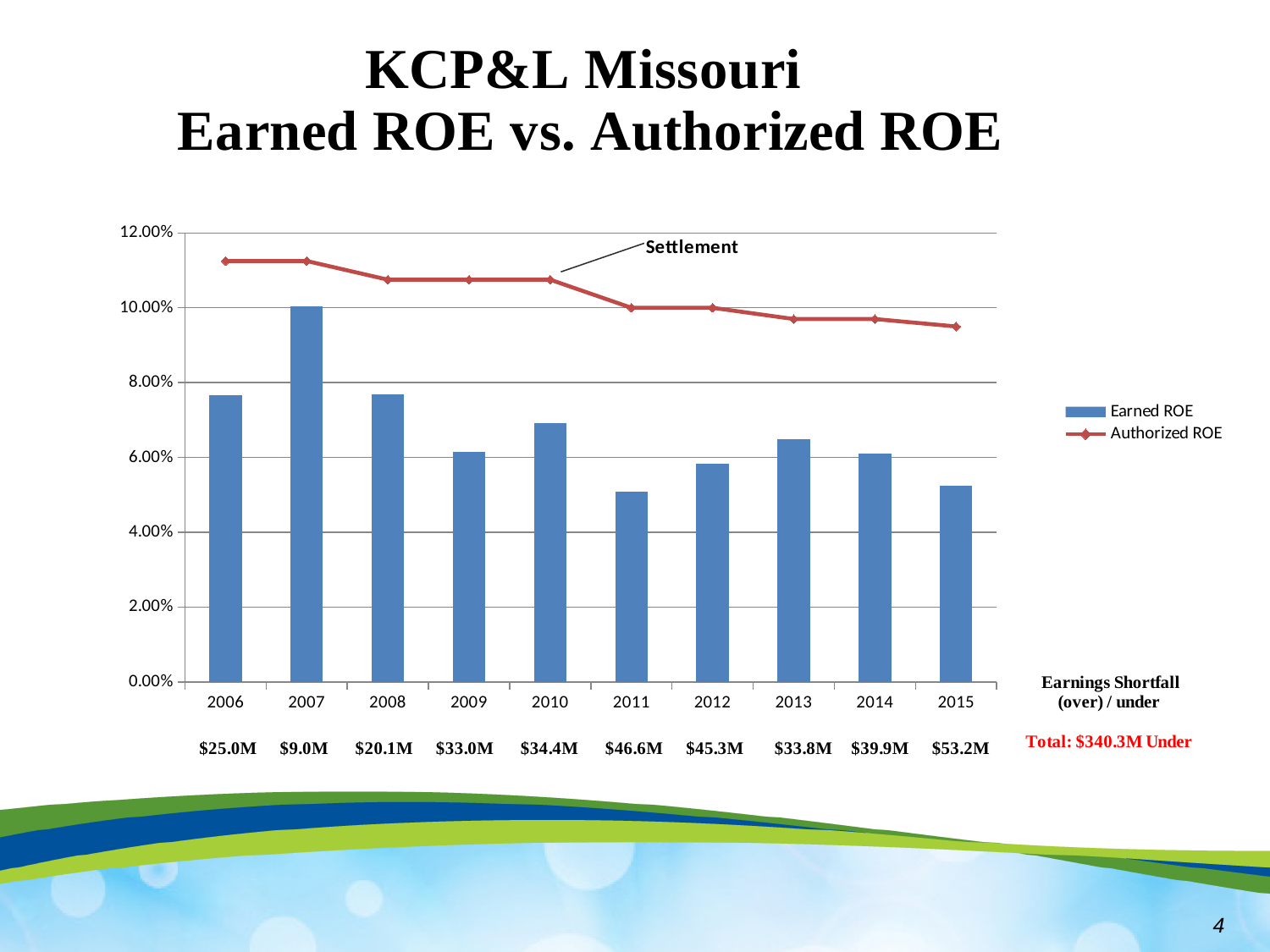
How many years are shown on the x axis of the chart? 10 Does the Authorized ROE line rise or fall from 2006 to 2015? It falls What total earnings shortfall is shown on the slide? $340.3M Under What kind of chart is shown on the slide? A bar chart with a line series What is the earnings shortfall shown for 2015? $53.2M What is the difference between the earnings shortfall for 2015 and for 2007? $44.2M Is the Authorized ROE for 2006 greater or less than 10.00%? greater Which is larger, the Earned ROE for 2007 or for 2009? 2007 How many series does the chart's legend list? 2 Is the Earned ROE for 2006 greater or less than 8.00%? less Is the Authorized ROE for 2015 greater or less than 10.00%? less Which year has the highest Earned ROE? 2007